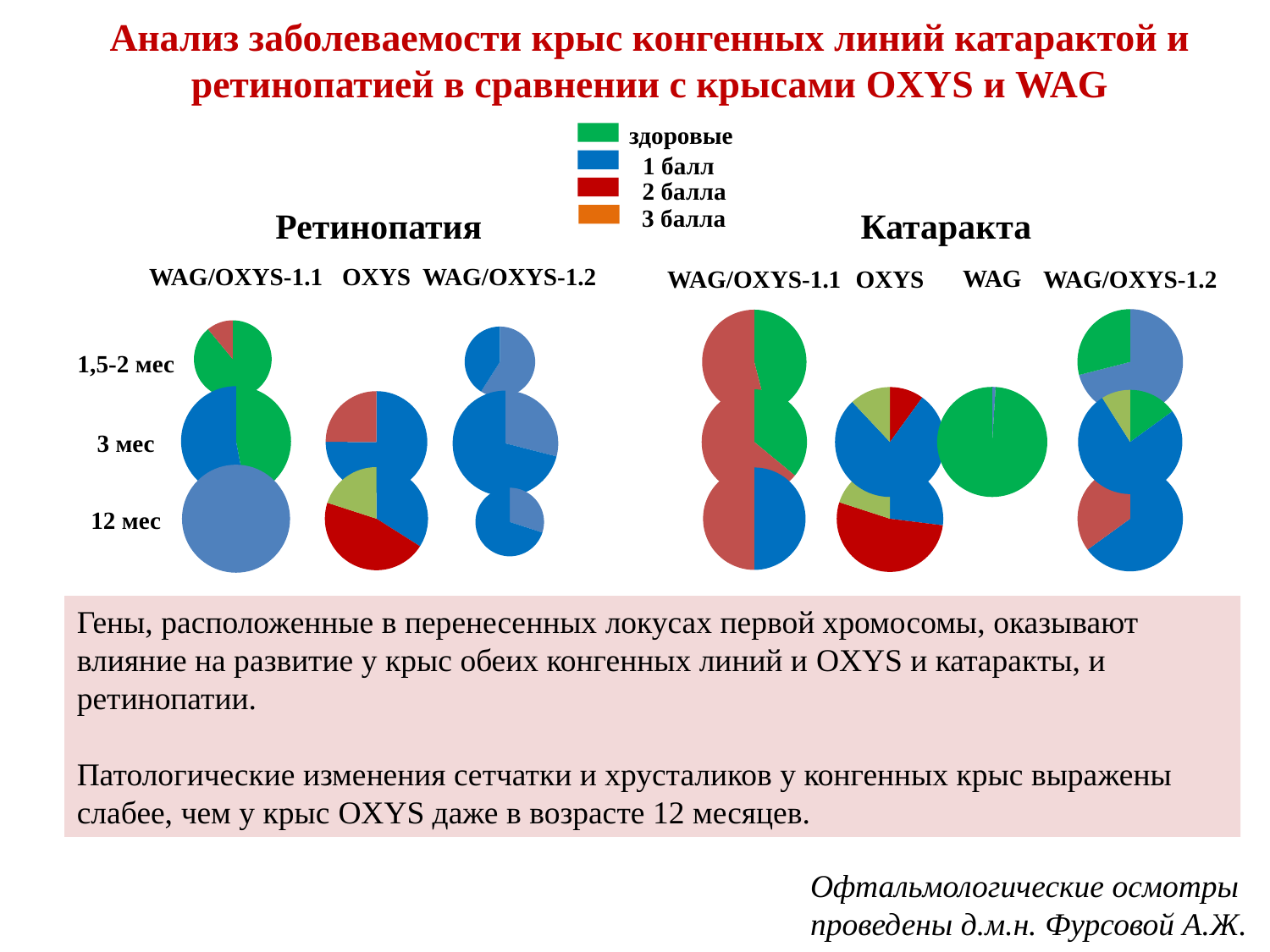
How many rat lines are shown in the Ретинопатия section? 3 What kind of chart is used on this slide to show the incidence of retinopathy and cataract? pie chart How many rat lines are shown in the Катаракта section? 4 How many age groups are labelled along the left side of the pie charts? 3 Which colour represents the category '2 балла' in the legend? red In the Ретинопатия section, which category is the largest in the pie for WAG/OXYS-1.1 at 1,5-2 мес? здоровые In the Катаракта section, which category makes up almost the whole pie for WAG? здоровые In the Катаракта section, which category is the largest in the pie for OXYS at 12 мес? 2 балла How many categories does the legend list? 4 Which colour represents the category 'здоровые' in the legend? green In the Ретинопатия section, which category fills the entire pie for WAG/OXYS-1.1 at 12 мес? 1 балл